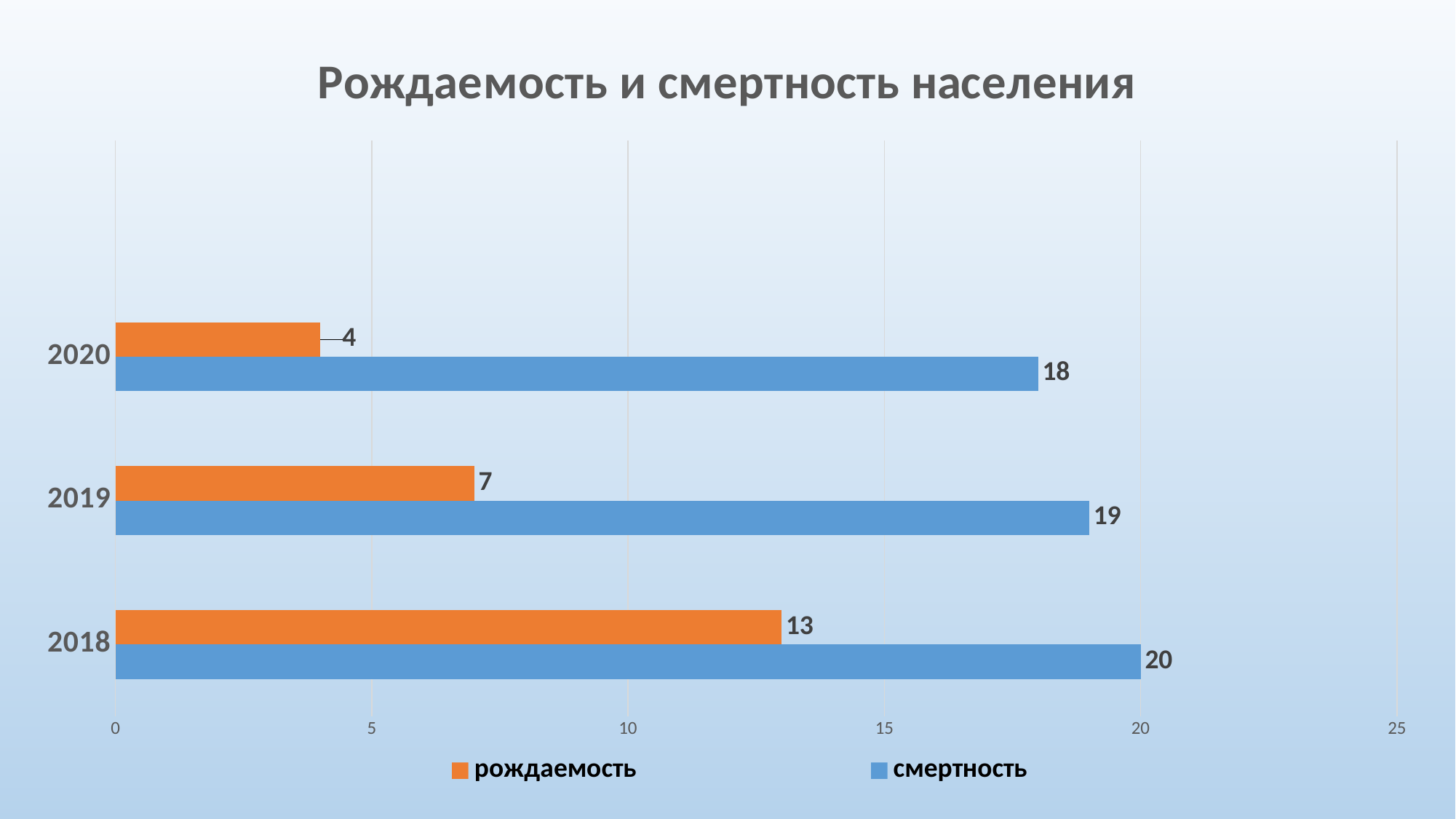
How many years are shown on the chart? 3 Which year has the highest value for рождаемость? 2018 What is the value for рождаемость in 2020? 4 What is the value for смертность in 2019? 19 What is the difference between смертность and рождаемость in 2020? 14 What kind of chart is shown on the slide? bar chart What is the value for рождаемость in 2019? 7 Which year has the lowest value for смертность? 2020 What is the value for смертность in 2018? 20 What is the title of the chart? Рождаемость и смертность населения How many series does the legend list? 2 Which is larger in 2018: рождаемость or смертность? смертность